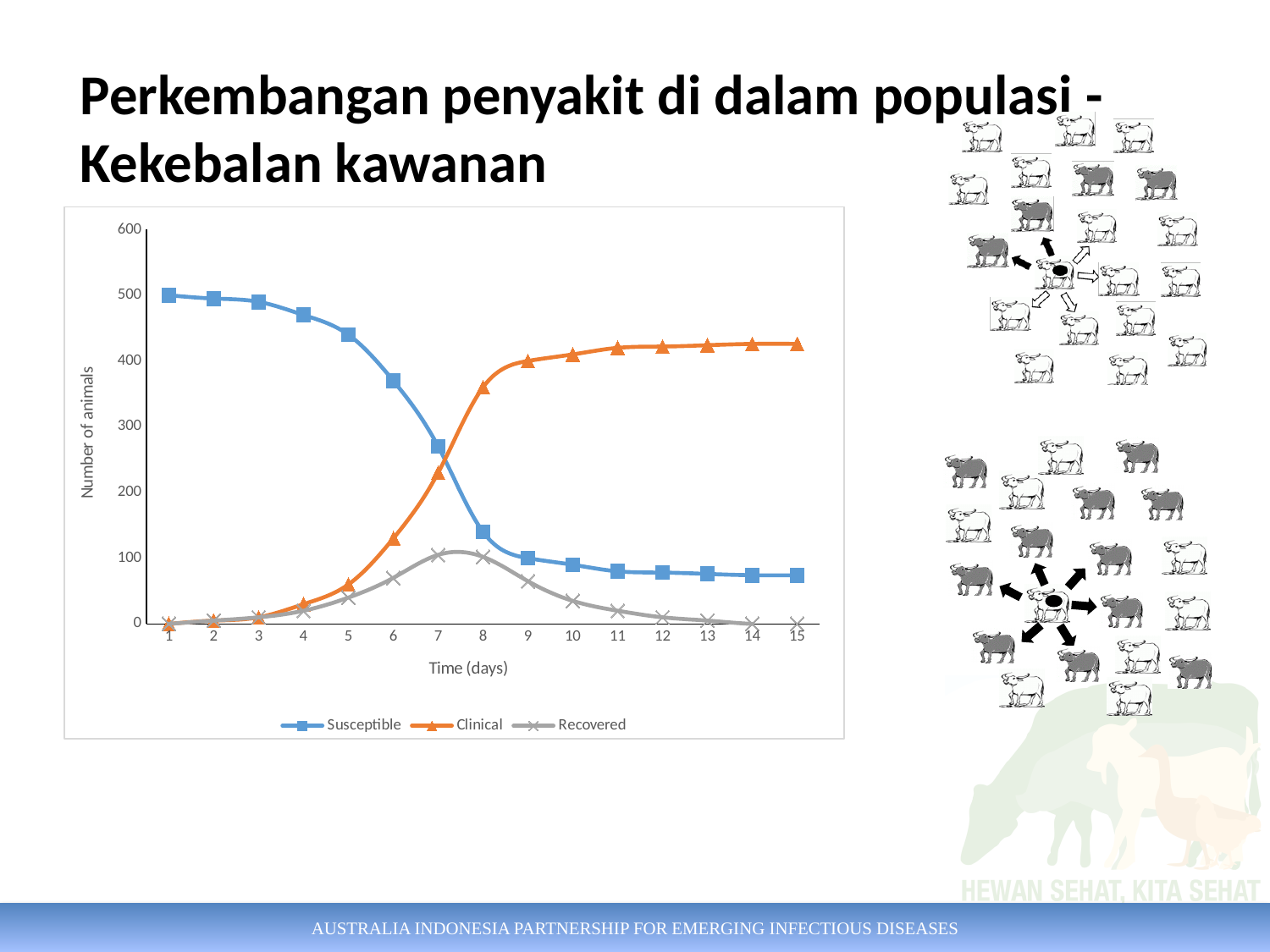
At day 8, which is larger: the Susceptible value or the Clinical value? Clinical How many time points (days) are plotted on the x axis? 15 What is the label of the y axis? Number of animals Is the Susceptible value at day 1 greater or less than 400? greater Which series has the highest value at day 15? Clinical Is the Susceptible value at day 15 greater or less than 100? less Does the Susceptible series rise or fall from day 1 to day 15? fall What is the label of the x axis? Time (days) Is the Clinical value at day 15 greater or less than 400? greater What kind of chart is shown on the slide? line chart How many series does the chart legend list? 3 Does the Clinical series rise or fall from day 1 to day 15? rise